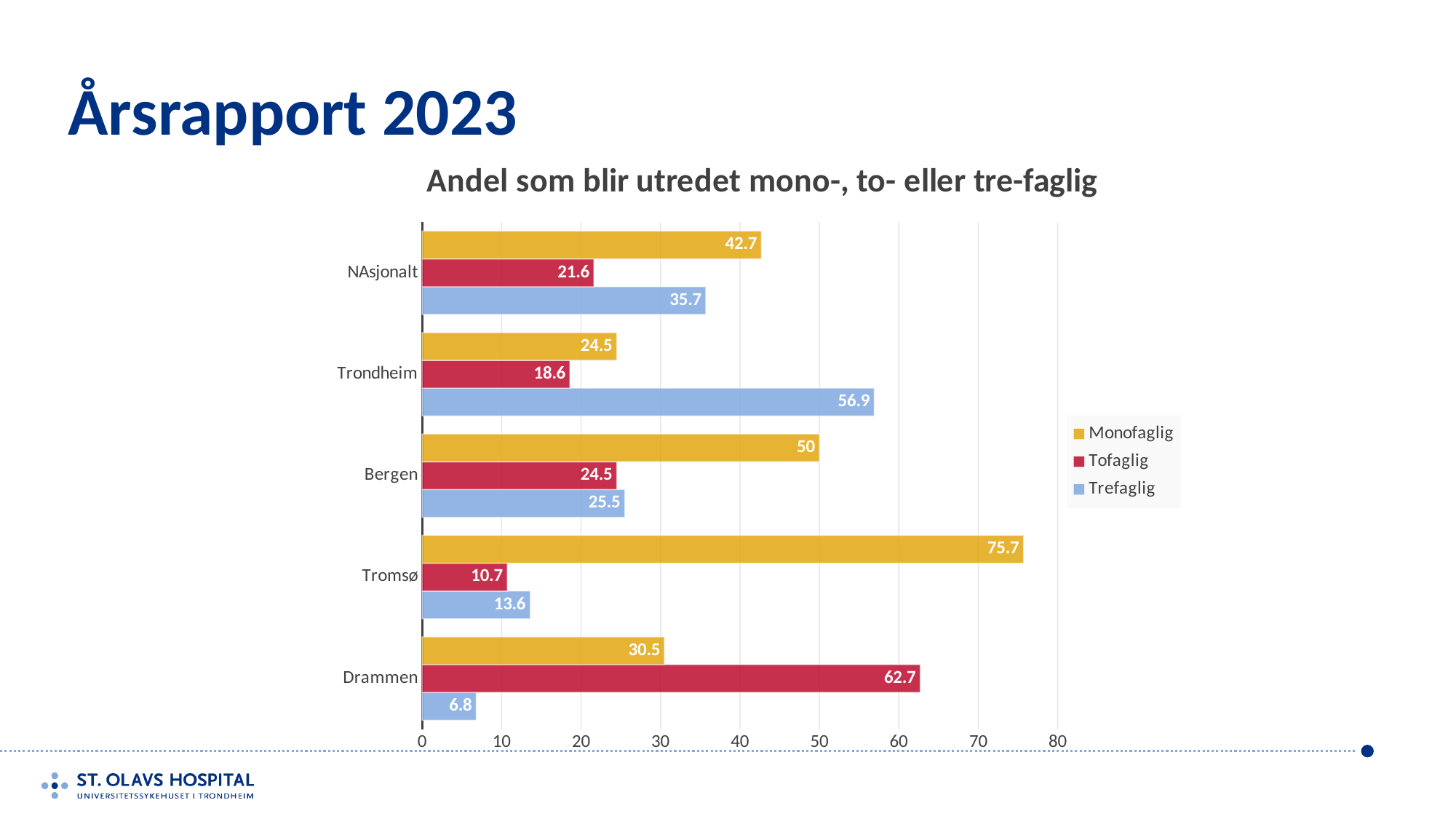
What is the title of the chart? Andel som blir utredet mono-, to- eller tre-faglig Which is larger for Trondheim, the Monofaglig value or the Trefaglig value? Trefaglig What is the Trefaglig value for NAsjonalt? 35.7 How many categories are shown on the chart? 5 How many series does the legend list? 3 What is the difference between the Monofaglig and Tofaglig values for Bergen? 25.5 What is the Trefaglig value for Trondheim? 56.9 What is the Tofaglig value for Drammen? 62.7 Which category has the highest Monofaglig value? Tromsø What is the Monofaglig value for Tromsø? 75.7 Which category has the lowest Trefaglig value? Drammen What kind of chart is shown on the slide? Bar chart